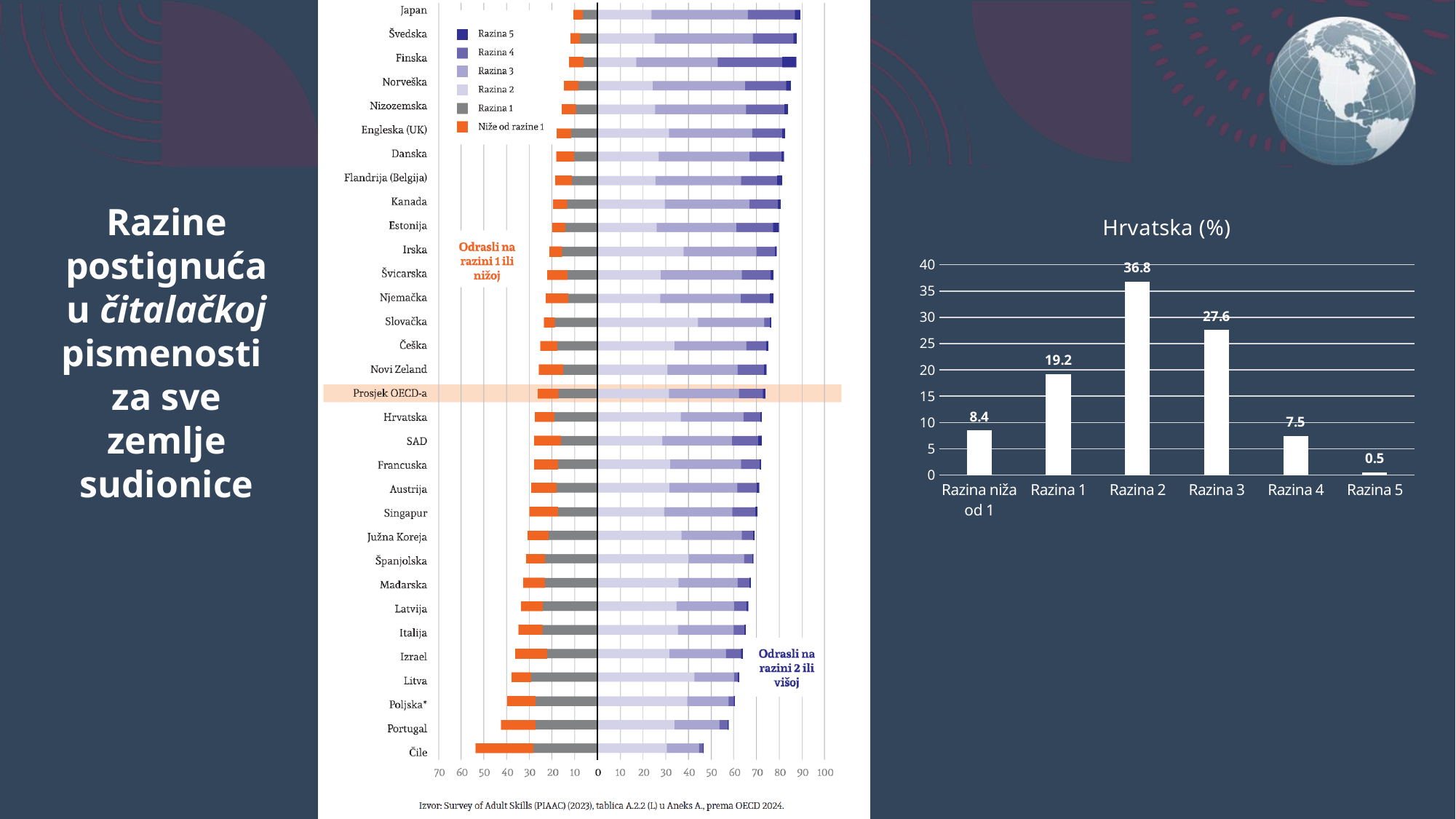
In the chart titled 'Hrvatska (%)', how many categories are shown on the x axis? 6 What kind of chart is the chart titled 'Hrvatska (%)'? bar chart In the chart titled 'Hrvatska (%)', what is the value for Razina 2? 36.8 In the left chart of countries, how many series does the legend list? 6 In the chart titled 'Hrvatska (%)', what is the difference between the values for Razina 2 and Razina 3? 9.2 In the chart titled 'Hrvatska (%)', what is the value for Razina niža od 1? 8.4 In the chart titled 'Hrvatska (%)', which category has the lowest value? Razina 5 In the left chart of countries, which country is listed at the top of the chart? Japan In the chart titled 'Hrvatska (%)', what is the value for Razina 4? 7.5 In the chart titled 'Hrvatska (%)', which category has the highest value? Razina 2 In the chart titled 'Hrvatska (%)', which is larger, the value for Razina 1 or the value for Razina 4? Razina 1 In the left chart of countries, is the share of adults at level 1 or lower ('Odrasli na razini 1 ili nižoj') for Čile greater or less than 40? greater